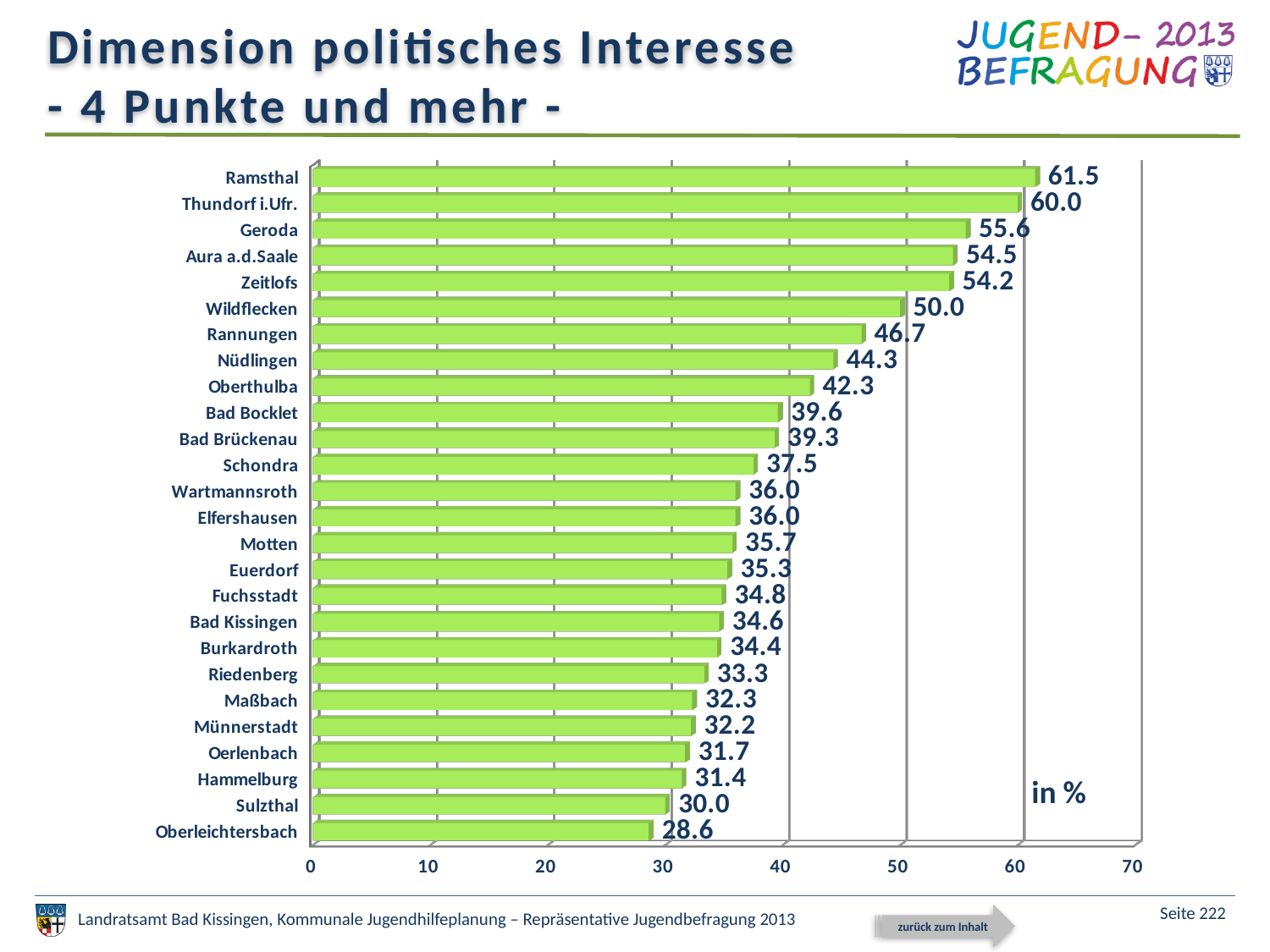
What is the value for Bad Kissingen? 34.6 What is the value for Wildflecken? 50.0 Is the value for Hammelburg greater or less than 40? less Which municipality has the highest value? Ramsthal What unit is indicated for the values in the chart? in % Which has a larger value, Nüdlingen or Schondra? Nüdlingen What kind of chart is shown on the slide? bar chart What is the value for Ramsthal? 61.5 How many municipalities are shown in the chart? 26 What is the difference between the values for Ramsthal and Oberleichtersbach? 32.9 Which municipality has the lowest value? Oberleichtersbach What is the difference between the values for Geroda and Zeitlofs? 1.4